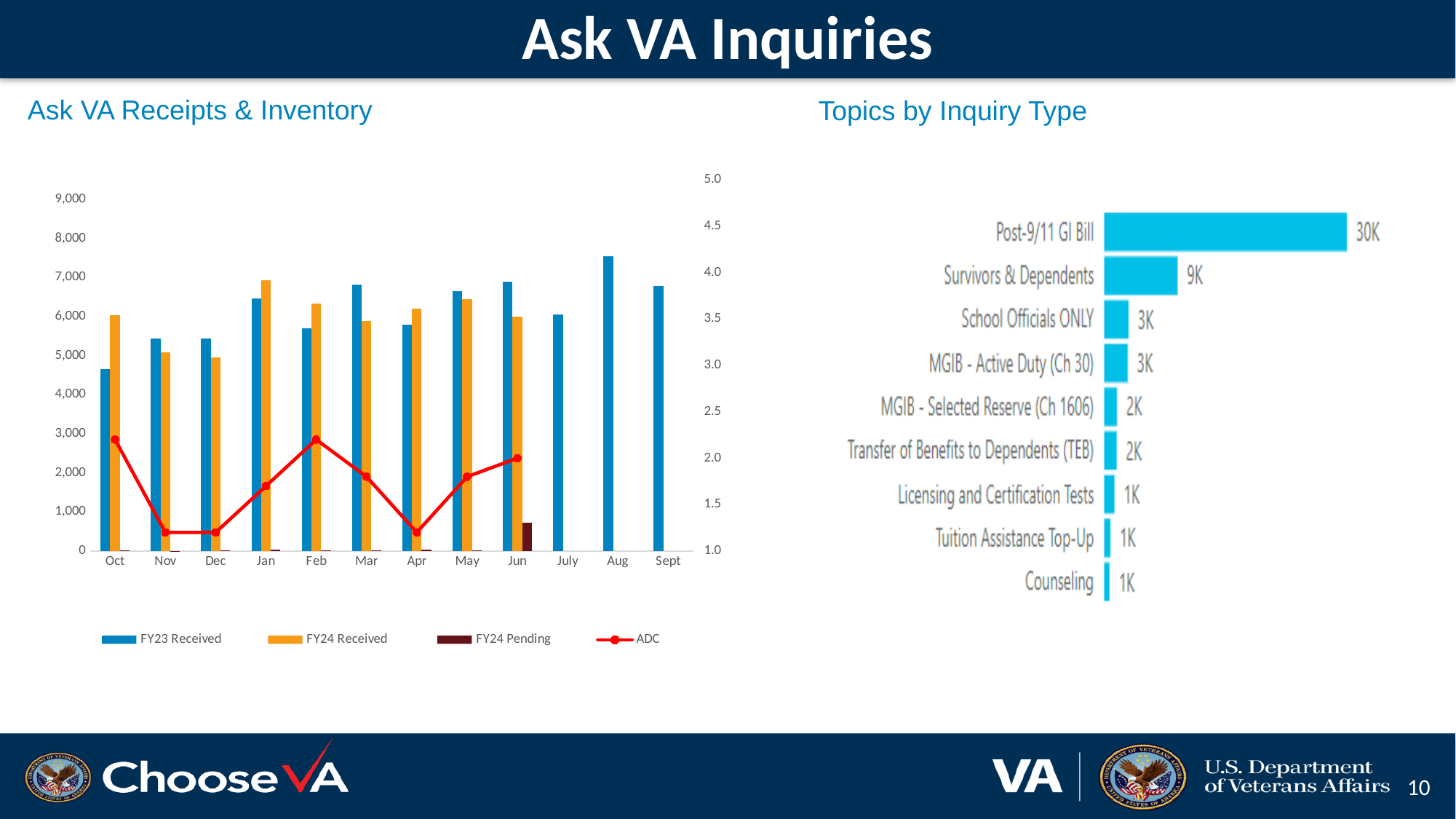
In the Ask VA Receipts & Inventory chart, how many months are shown on the x axis? 12 In the Ask VA Receipts & Inventory chart, does the ADC line rise or fall from Feb to Apr? fall In the Ask VA Receipts & Inventory chart, is the ADC value for Nov greater or less than 1.5? less In the Topics by Inquiry Type chart, what is the difference between Post-9/11 GI Bill and Survivors & Dependents? 21K In the Topics by Inquiry Type chart, which topic has the highest value? Post-9/11 GI Bill In the Ask VA Receipts & Inventory chart, how many series does the legend list? 4 In the Ask VA Receipts & Inventory chart, in which month is FY23 Received highest? Aug In the Ask VA Receipts & Inventory chart, is the FY23 Received value for Aug greater or less than 7,000? greater In the Topics by Inquiry Type chart, which is larger, School Officials ONLY or Licensing and Certification Tests? School Officials ONLY In the Topics by Inquiry Type chart, what is the value for Survivors & Dependents? 9K In the Topics by Inquiry Type chart, what is the value for Post-9/11 GI Bill? 30K In the Topics by Inquiry Type chart, how many topics are listed? 9